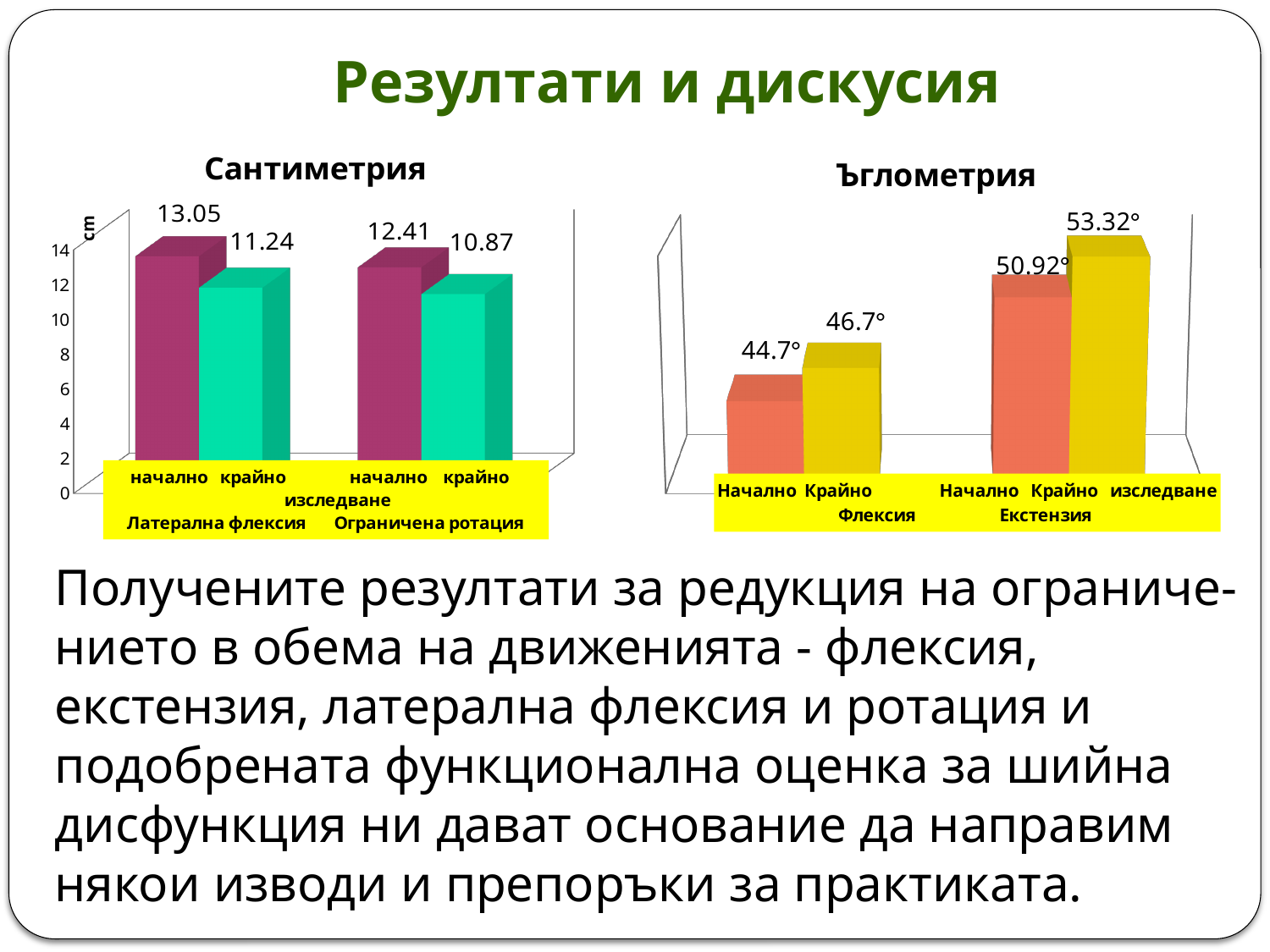
In the Сантиметрия chart, what is the difference between the начално and крайно values for Латерална флексия? 1.81 In the Сантиметрия chart, what is the value of the начално bar for Латерална флексия? 13.05 In the Ъглометрия chart, which is larger: the Крайно value for Флексия or the Начално value for Екстензия? Начално value for Екстензия (50.92°) In the Ъглометрия chart, which bar has the lowest value? Начално, Флексия (44.7°) In the Сантиметрия chart, which bar has the highest value? начално, Латерална флексия (13.05) In the Ъглометрия chart, what is the value of the Крайно bar for Екстензия? 53.32° In the Сантиметрия chart, is the крайно value for Ограничена ротация greater or less than 12? less What type of chart is the Ъглометрия chart? bar chart In the Сантиметрия chart, what is the value of the крайно bar for Ограничена ротация? 10.87 In the Ъглометрия chart, what is the value of the Начално bar for Флексия? 44.7° In the Сантиметрия chart, what unit is shown on the vertical axis? cm In the Ъглометрия chart, what is the difference between the Крайно and Начално values for Екстензия? 2.4°